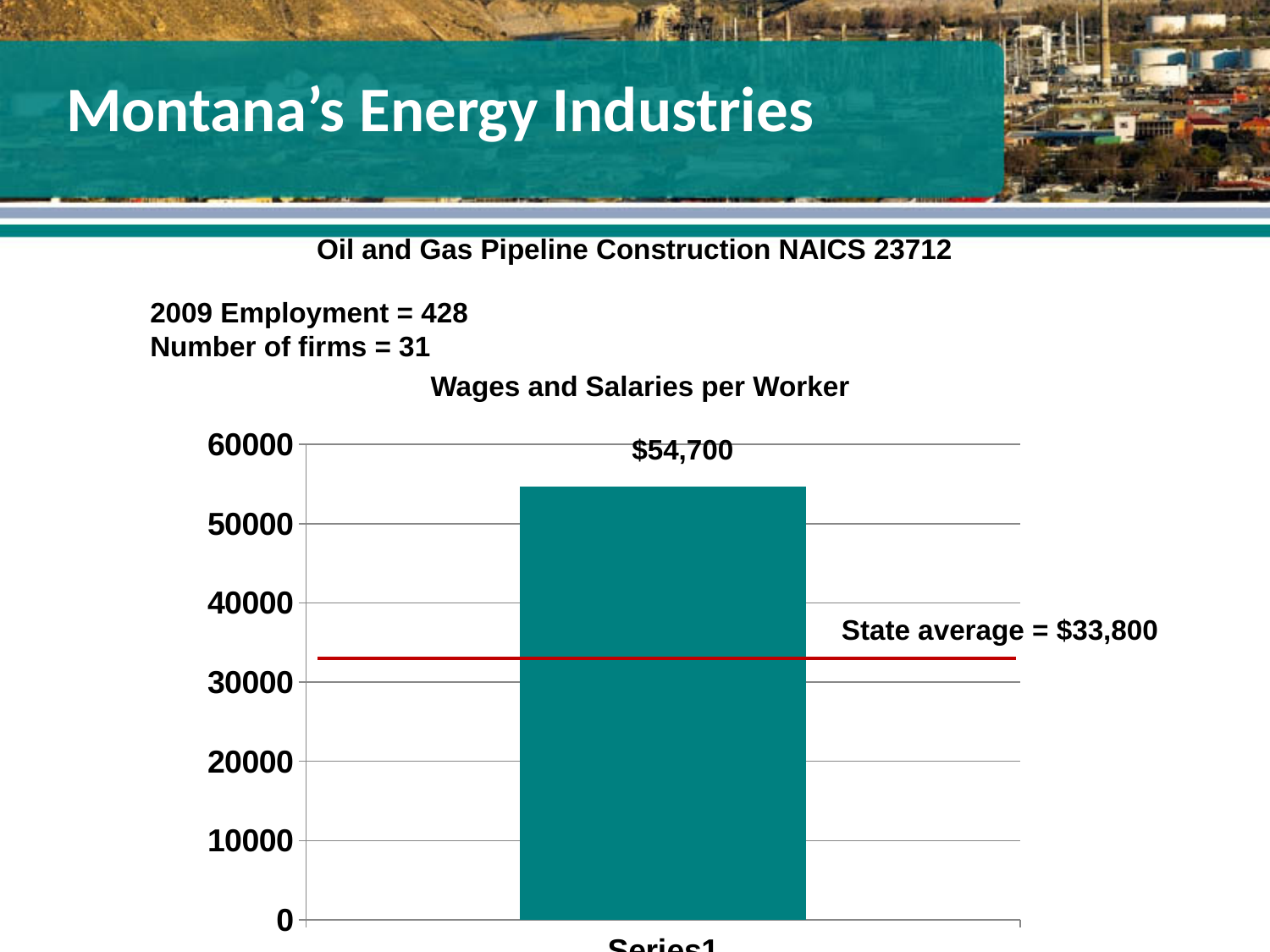
What is the title of the chart? Wages and Salaries per Worker Is the value of the bar greater or less than 60000? less What is the state average shown by the red line on the chart? $33,800 What is the highest value shown on the vertical axis of the chart? 60000 Is the value of the bar greater or less than 50000? greater Which is larger, the wages per worker bar or the state average line? the wages per worker bar What value is printed on the bar in the Wages and Salaries per Worker chart? $54,700 Is the state average line greater or less than 40000? less What is the difference between the wages per worker bar ($54,700) and the state average ($33,800)? $20,900 How many bars are plotted in the chart? 1 What kind of chart is shown on the slide? bar chart